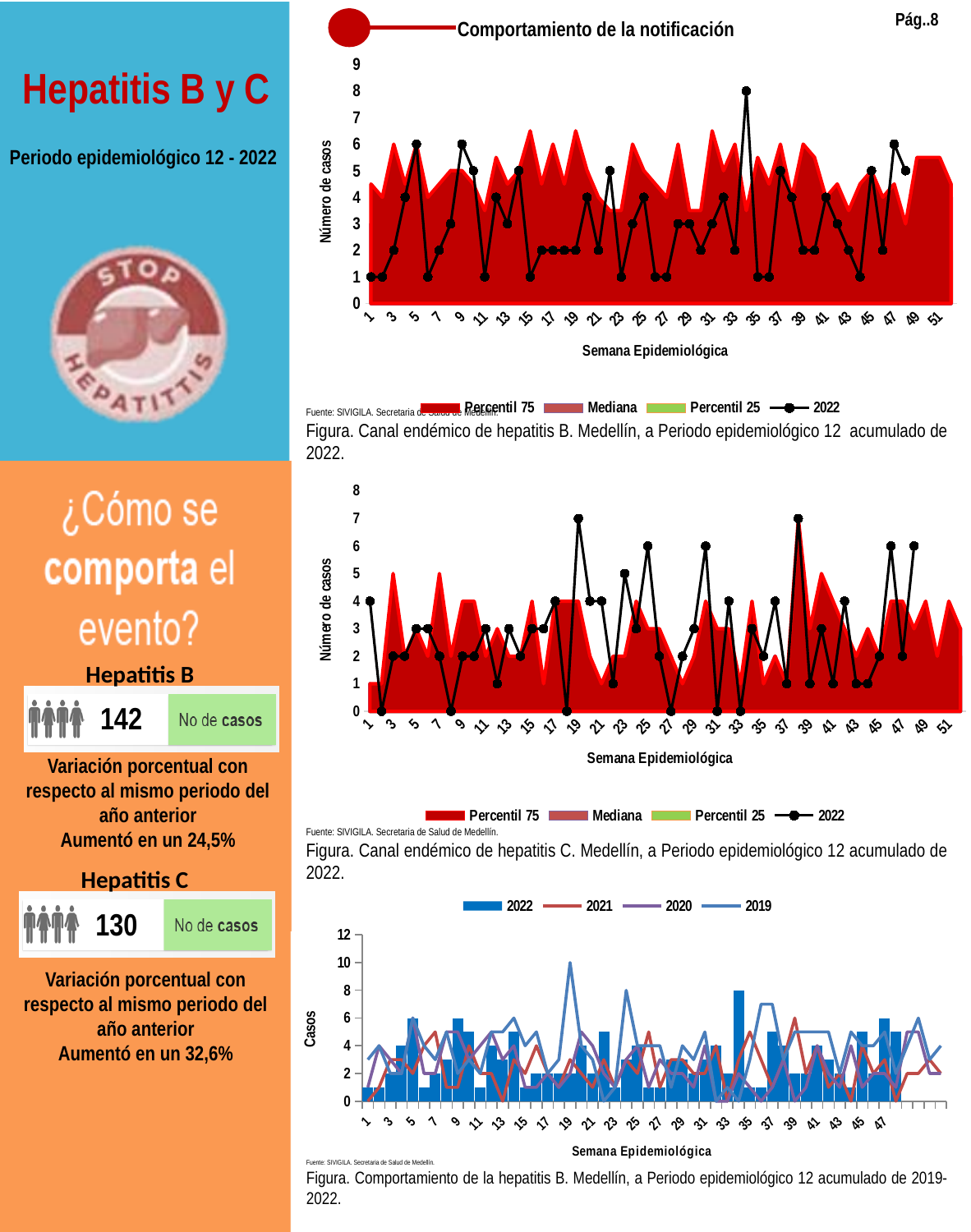
In the bottom chart (Comportamiento de la hepatitis B 2019-2022), how many series does the legend list? 4 In the bottom chart (Comportamiento de la hepatitis B 2019-2022), which series is drawn as bars? 2022 What is the y-axis title of the top chart (Canal endémico de hepatitis B)? Número de casos In the top chart (Canal endémico de hepatitis B), is the 2022 value for week 1 greater or less than 3? less In the middle chart (Canal endémico de hepatitis C), what is the 2022 value at week 19? 7 In the bottom chart (Comportamiento de la hepatitis B 2019-2022), is the 2019 value for week 19 greater or less than 8? greater In the bottom chart (Comportamiento de la hepatitis B 2019-2022), which week has the tallest 2022 bar? Week 34 In the middle chart (Canal endémico de hepatitis C), is the 2022 value for week 19 greater or less than 5? greater In the top chart (Canal endémico de hepatitis B), which epidemiological week has the highest 2022 value? Week 34 In the top chart (Canal endémico de hepatitis B), what is the 2022 value at week 34? 8 In the top chart (Canal endémico de hepatitis B), how many series does the legend list? 4 In the top chart (Canal endémico de hepatitis B), which is larger, the 2022 value at week 34 or at week 1? Week 34